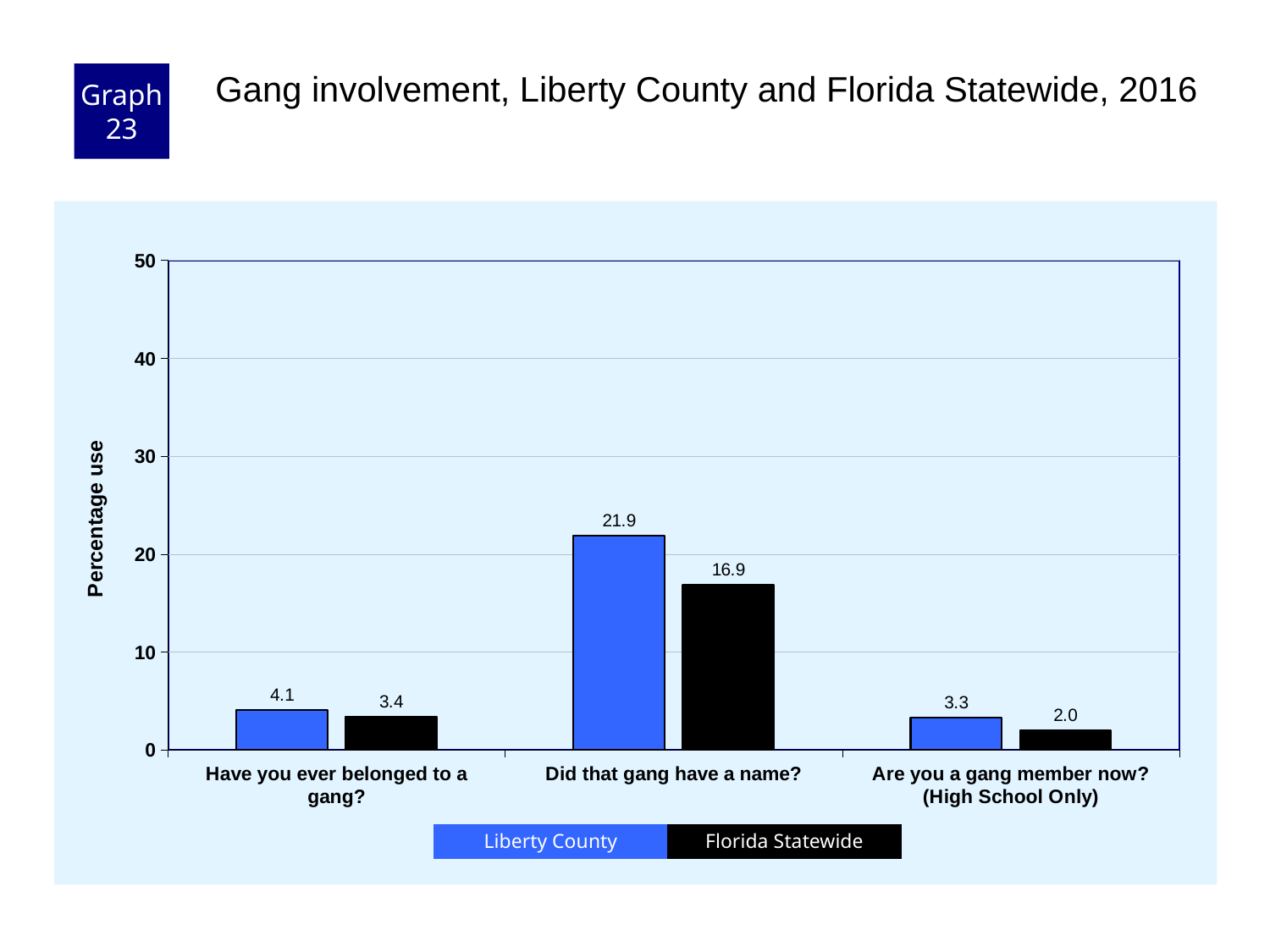
What kind of chart is shown on the slide? Bar chart What is the Florida Statewide value for "Have you ever belonged to a gang?"? 3.4 What is the label of the y axis? Percentage use What is the difference between the Liberty County and Florida Statewide values for "Did that gang have a name?"? 5.0 What is the Liberty County value for "Did that gang have a name?"? 21.9 Is the Liberty County value for "Did that gang have a name?" greater or less than 20? greater What is the Florida Statewide value for "Are you a gang member now? (High School Only)"? 2.0 For "Have you ever belonged to a gang?", which is larger: Liberty County or Florida Statewide? Liberty County How many categories are shown on the x axis? 3 How many series does the legend list? 2 Which category has the highest Liberty County value? Did that gang have a name? Which category has the lowest Florida Statewide value? Are you a gang member now? (High School Only)